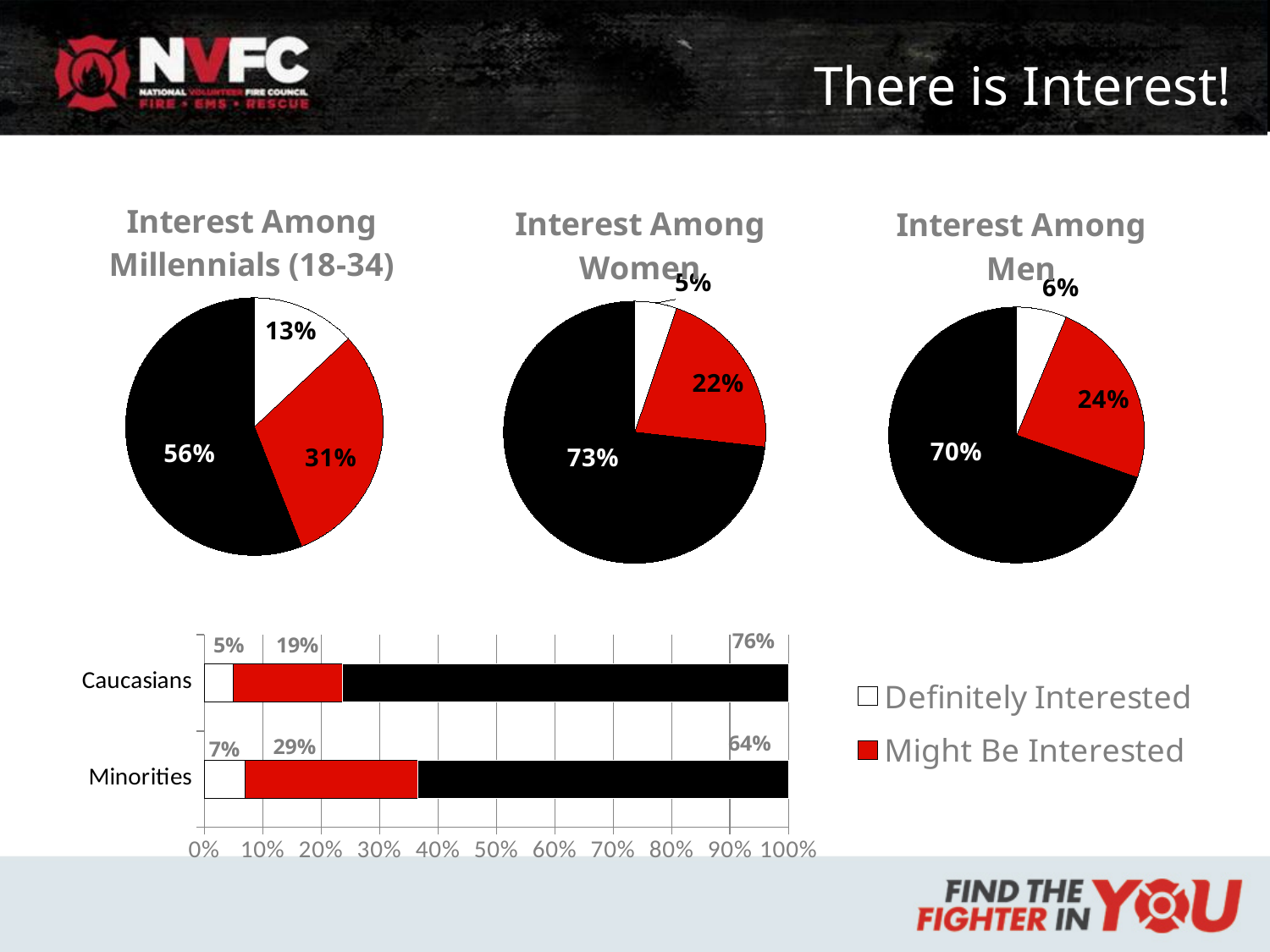
How many categories are shown in the bar chart at the bottom of the slide? 2 In the 'Interest Among Women' pie chart, what percentage is shown for Definitely Interested? 5% What is the difference between the Might Be Interested percentage in the 'Interest Among Millennials (18-34)' pie chart and the Might Be Interested percentage in the 'Interest Among Women' pie chart? 9 percentage points In the 'Interest Among Millennials (18-34)' pie chart, what is the percentage of the largest slice? 56% How many series does the legend next to the bottom bar chart list? 2 In the bar chart at the bottom of the slide, what is the Might Be Interested value for Minorities? 29% In the bar chart at the bottom of the slide, what is the Definitely Interested value for Caucasians? 5% In the 'Interest Among Men' pie chart, what percentage is shown for Might Be Interested? 24% In the bar chart at the bottom of the slide, which group has the larger Might Be Interested value, Caucasians or Minorities? Minorities What is the title of the leftmost pie chart on the slide? Interest Among Millennials (18-34) What kind of chart is shown at the bottom of the slide? Bar chart In the 'Interest Among Millennials (18-34)' pie chart, what percentage is shown for Might Be Interested? 31%